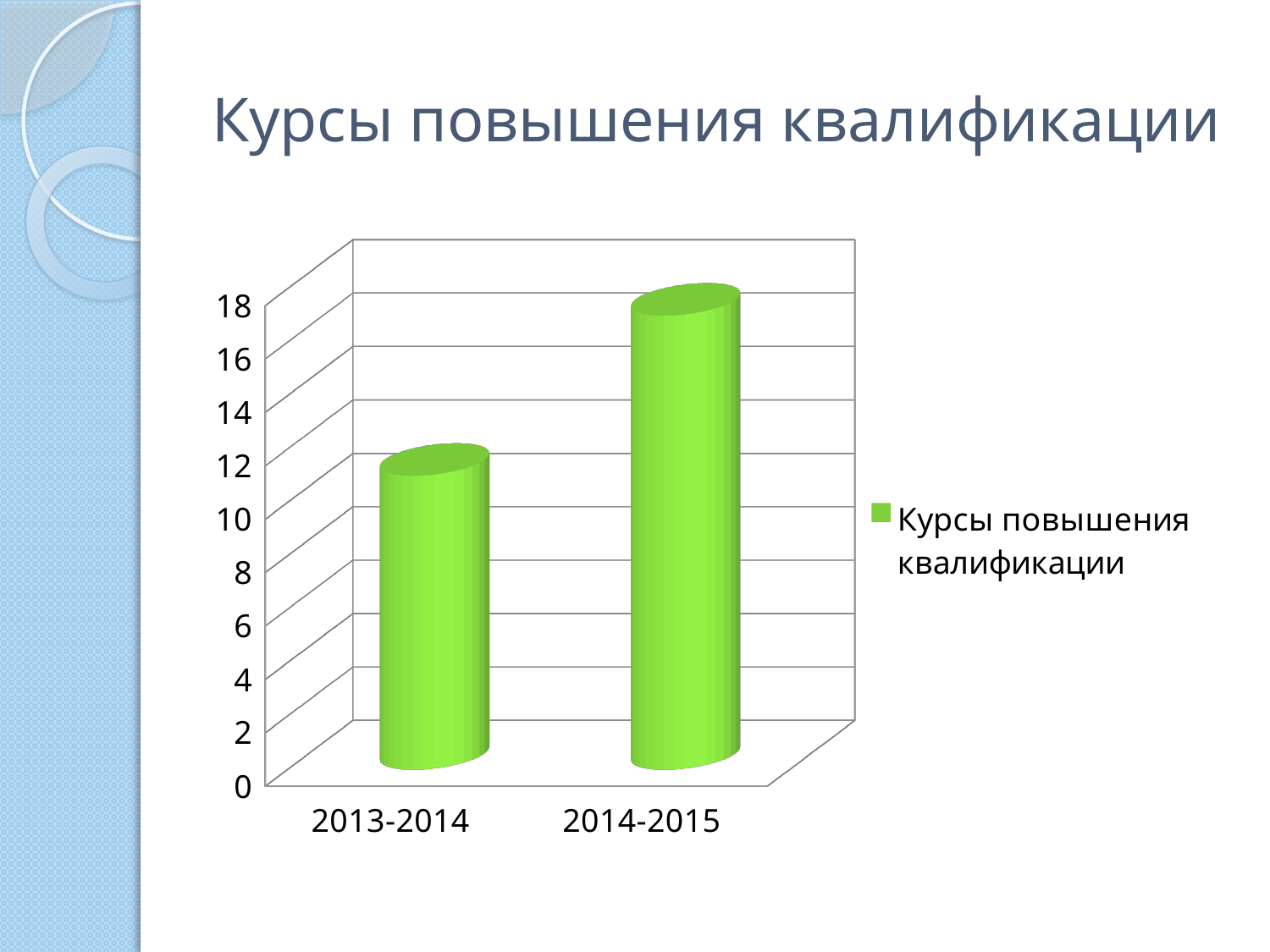
Is the value for 2013-2014 greater or less than 14? less Which category has the lowest value in the chart? 2013-2014 How many series does the chart legend list? 1 Do the values rise or fall from 2013-2014 to 2014-2015? rise Which is larger, the value for 2013-2014 or the value for 2014-2015? 2014-2015 Is the value for 2013-2014 greater or less than 8? greater What kind of chart is shown on the slide? bar chart What series name is shown in the chart legend? Курсы повышения квалификации Which category has the highest value in the chart? 2014-2015 What is the title of the chart on the slide? Курсы повышения квалификации How many categories are shown on the x axis of the chart? 2 Is the value for 2014-2015 greater or less than 14? greater